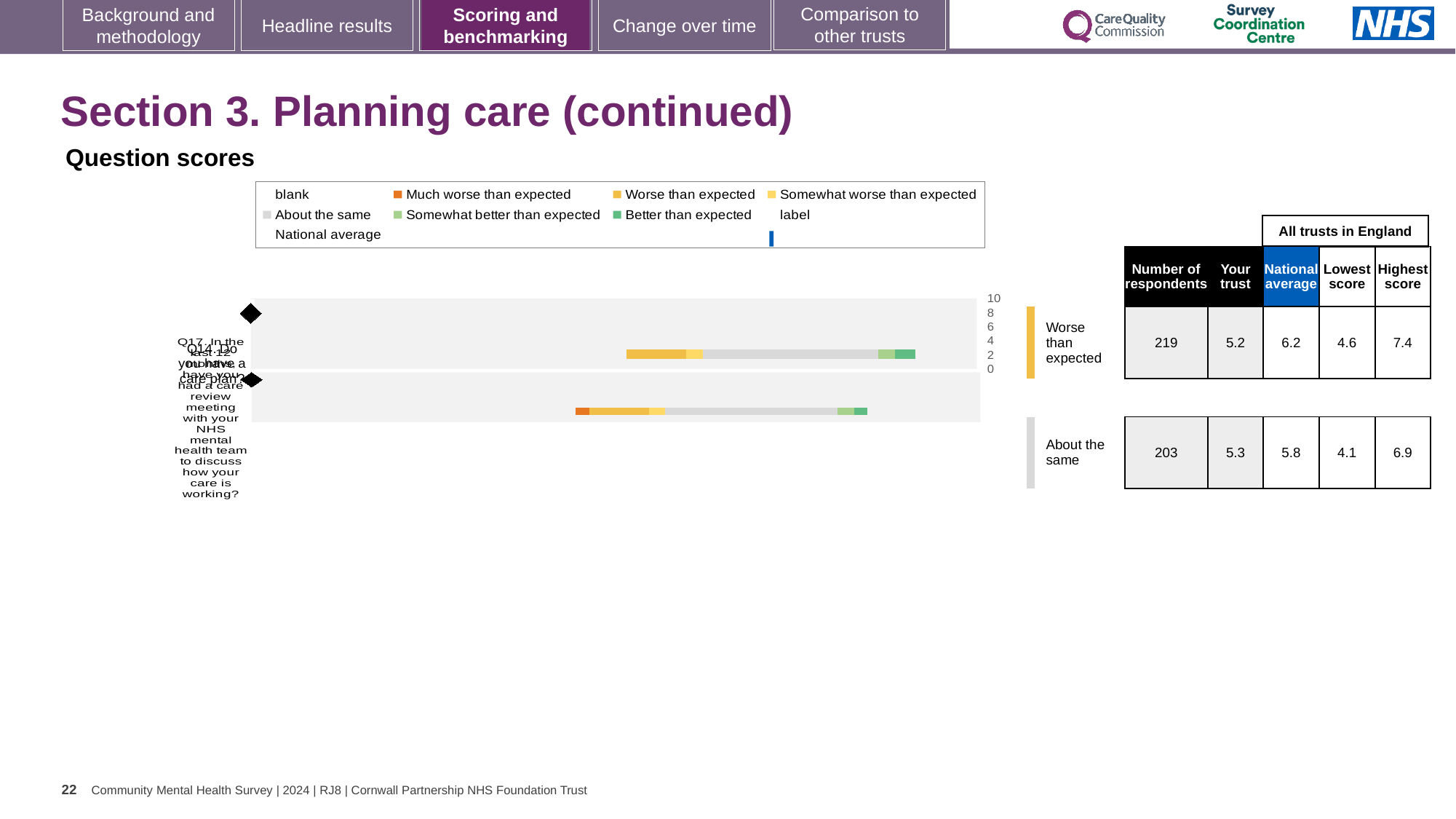
What is the lowest score among all trusts in England for the question rated 'About the same'? 4.1 How many respondents are shown for the question rated 'Worse than expected'? 219 How many question rows are plotted in the chart? 2 Which question row has more respondents, the one rated 'Worse than expected' or the one rated 'About the same'? Worse than expected For the question rated 'About the same', what is the difference between the highest and lowest scores among all trusts in England? 2.8 What is the 'Your trust' score for the question rated 'Worse than expected'? 5.2 For the question rated 'Worse than expected', what is the difference between the national average and the 'Your trust' score? 1.0 For the question rated 'About the same', is the 'Your trust' score higher or lower than the national average? lower According to the legend, what does the blue marker represent? National average What is the highest score among all trusts in England for the question rated 'Worse than expected'? 7.4 What is the national average for the question rated 'About the same'? 5.8 What kind of chart is used to show the question scores? bar chart